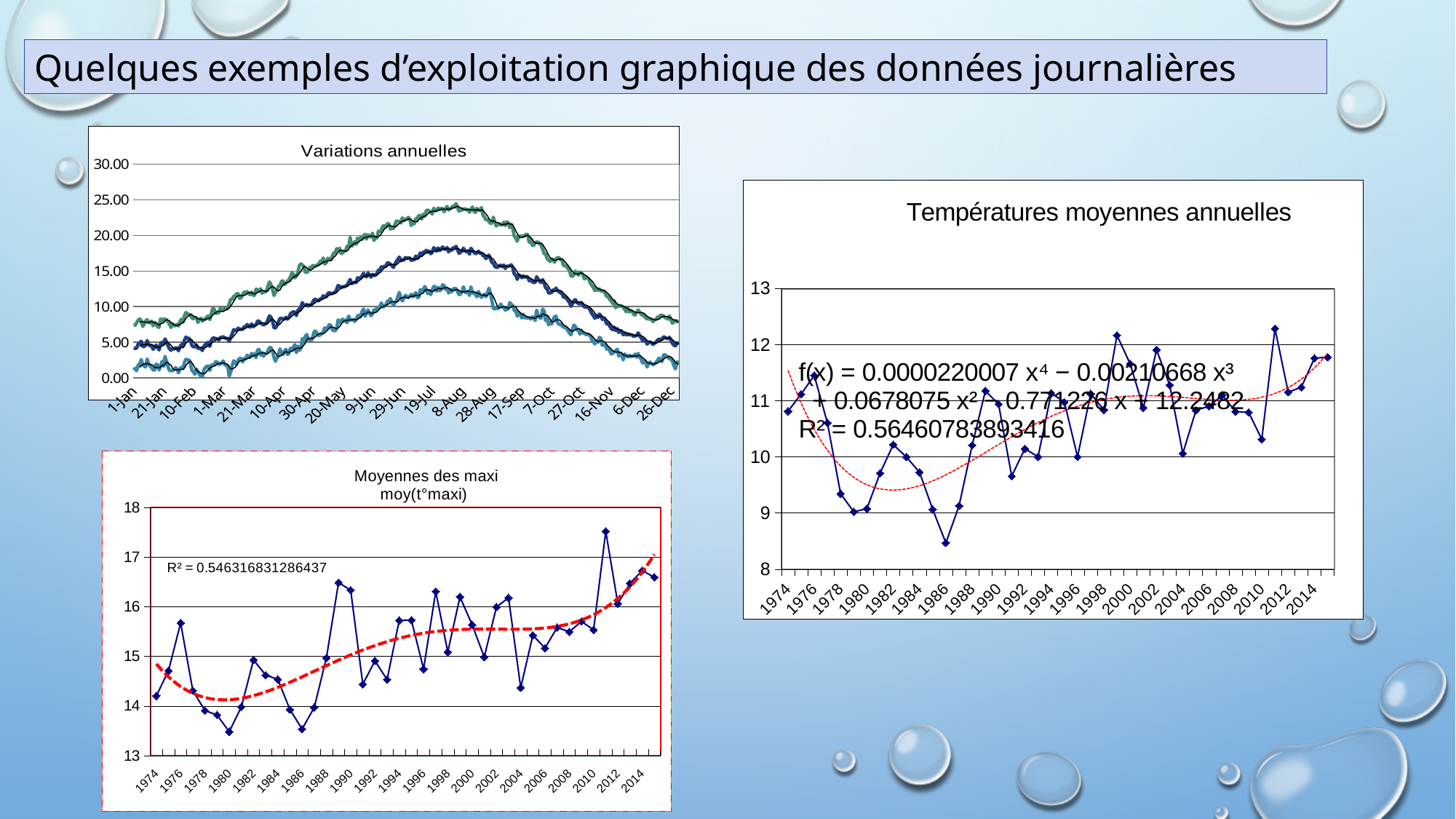
In the 'Moyennes des maxi' chart, which is larger, the value for 1974 or the value for 2014? 2014 In the 'Variations annuelles' chart, do the values rise or fall from 1-Jan to 8-Aug? Rise What R² value is shown on the 'Moyennes des maxi' chart? R² = 0.546316831286437 What kind of chart is the 'Températures moyennes annuelles' chart? Line chart In the 'Températures moyennes annuelles' chart, is the value for 1974 greater or less than 10? greater In the 'Températures moyennes annuelles' chart, is the lowest plotted value greater or less than 9? less What R² value is shown on the 'Températures moyennes annuelles' chart? R² = 0.56460783893416 In the 'Variations annuelles' chart, is the peak of the topmost line greater or less than 20.00? greater What kind of chart is the 'Variations annuelles' chart? Line chart